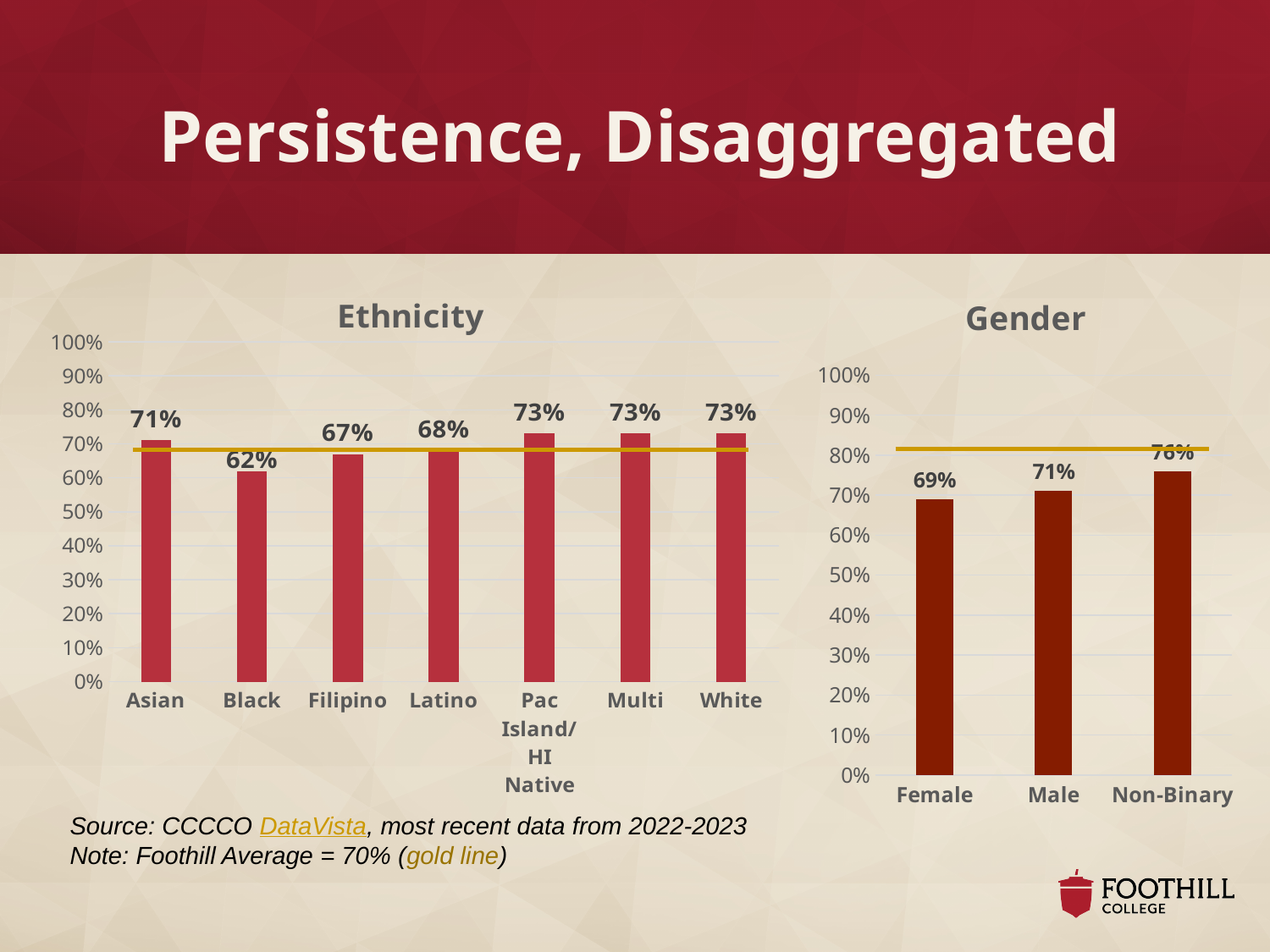
In the Ethnicity chart, what is the difference between the Asian value and the Black value? 9% In the Ethnicity chart, is the value for Black greater or less than 70%? less In the Ethnicity chart, which category has the lowest value? Black In the Ethnicity chart, which is larger, the value for Filipino or the value for Asian? Asian In the Gender chart, which category has the highest value? Non-Binary In the Gender chart, what is the value for Male? 71% In the Gender chart, what is the value for Female? 69% In the Ethnicity chart, what is the value for Latino? 68% How many categories are shown in the Ethnicity chart? 7 What kind of chart is the Gender chart? Bar chart According to the note on the slide, what does the gold line represent? Foothill Average = 70% In the Ethnicity chart, what is the persistence value for Black students? 62%